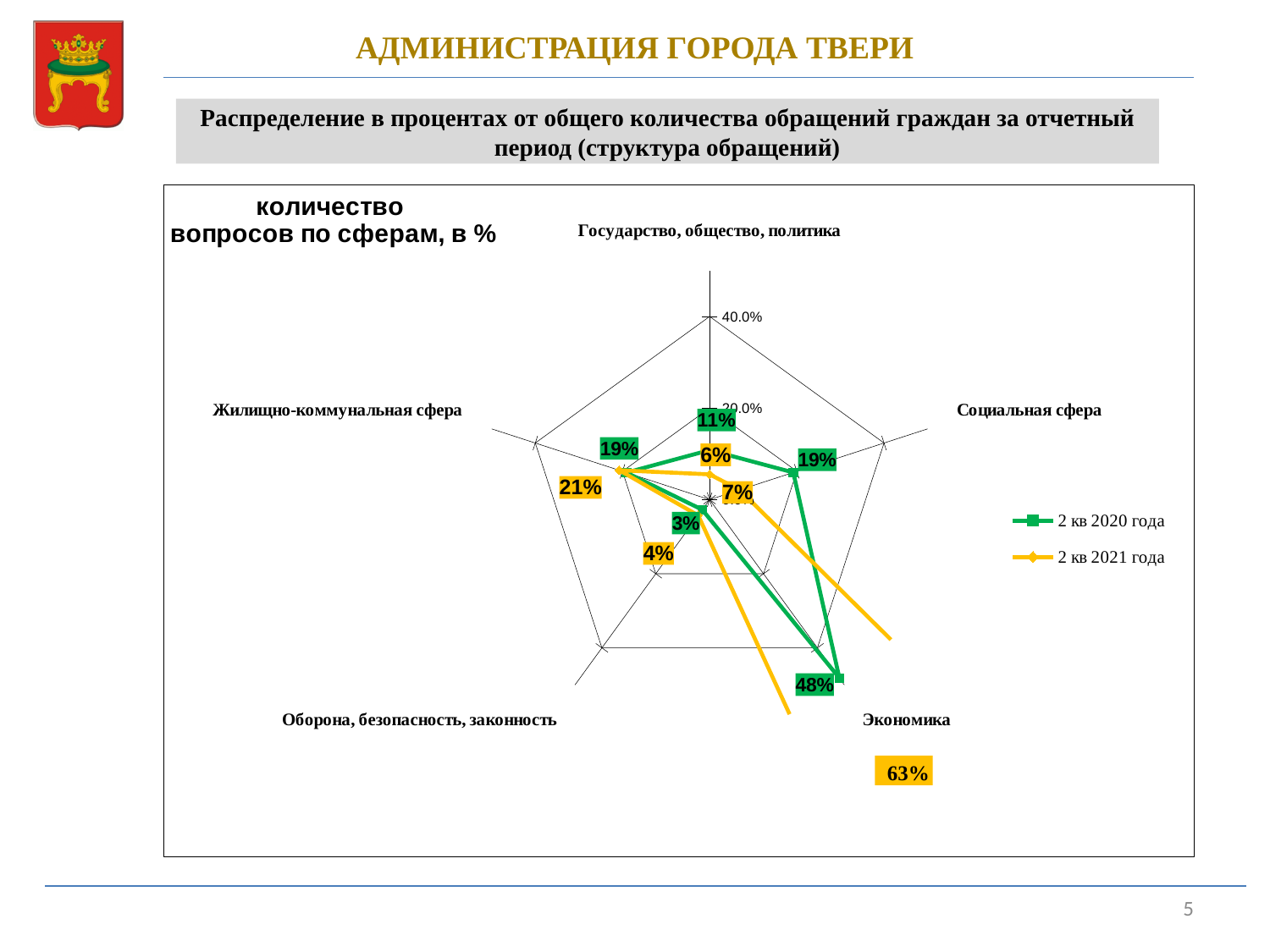
What is the difference between the 2 кв 2021 года and 2 кв 2020 года values for Экономика? 15% How many series does the legend list? 2 What kind of chart is shown on the slide? Radar chart Which category has the highest value in the 2 кв 2021 года series? Экономика What is the value for Жилищно-коммунальная сфера in the 2 кв 2021 года series? 21% What colour is used for the 2 кв 2021 года series? Yellow Which category has the lowest value in the 2 кв 2020 года series? Оборона, безопасность, законность How many categories (spheres) are plotted on the chart? 5 For Социальная сфера, which series has the larger value: 2 кв 2020 года or 2 кв 2021 года? 2 кв 2020 года What is the value for Экономика in the 2 кв 2020 года series? 48% What is the value for Экономика in the 2 кв 2021 года series? 63% What is the value for Социальная сфера in the 2 кв 2020 года series? 19%